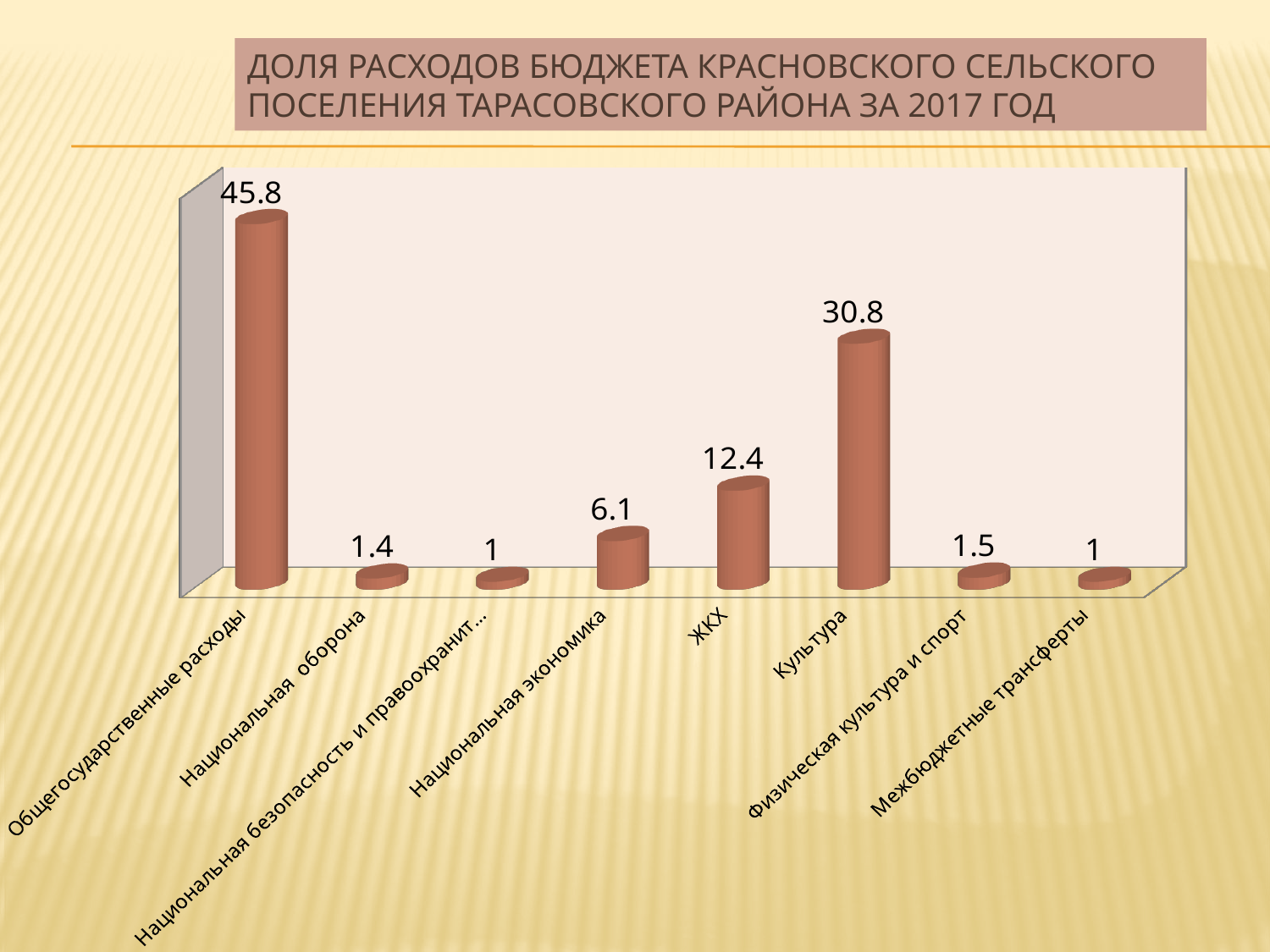
How many categories are shown in the chart? 8 What is the value for Культура? 30.8 Which category has the highest value? Общегосударственные расходы What is the difference between the values for ЖКХ and Национальная экономика? 6.3 What is the value for Межбюджетные трансферты? 1 What is the value for Национальная экономика? 6.1 What is the difference between the values for Общегосударственные расходы and Культура? 15 What is the value for Физическая культура и спорт? 1.5 Which is larger, the value for Национальная оборона or the value for Физическая культура и спорт? Физическая культура и спорт What kind of chart is shown on the slide? Bar chart What is the value for ЖКХ? 12.4 What year does the chart title say the budget expenditure shares are for? 2017